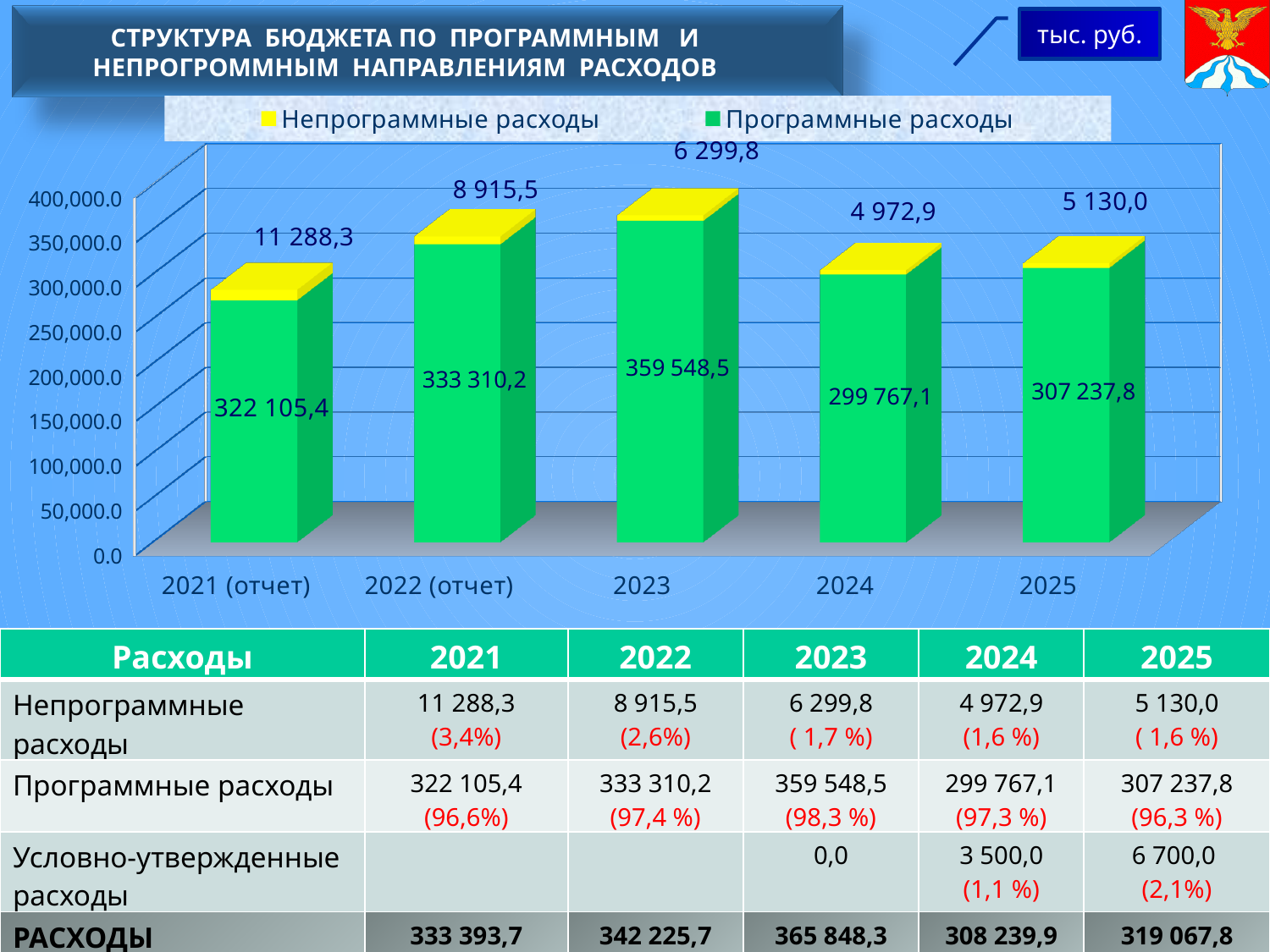
In which year are Программные расходы highest in the chart? 2023 Which year has the highest Непрограммные расходы in the chart? 2021 (отчет) What type of chart is shown on the slide? Stacked bar chart What is the difference between Программные расходы in 2023 and in 2022 (отчет)? 26 238,3 What is the value of Программные расходы for 2023 in the chart? 359 548,5 What is the total of the stacked bar for 2021 (отчет)? 333 393,7 How many year categories are shown on the x axis of the chart? 5 What is the value of Непрограммные расходы for 2021 (отчет) in the chart? 11 288,3 Which series is shown in yellow in the chart? Непрограммные расходы How many series does the chart legend list? 2 What is the value of Непрограммные расходы for 2025 in the chart? 5 130,0 In which year are Программные расходы lowest in the chart? 2024